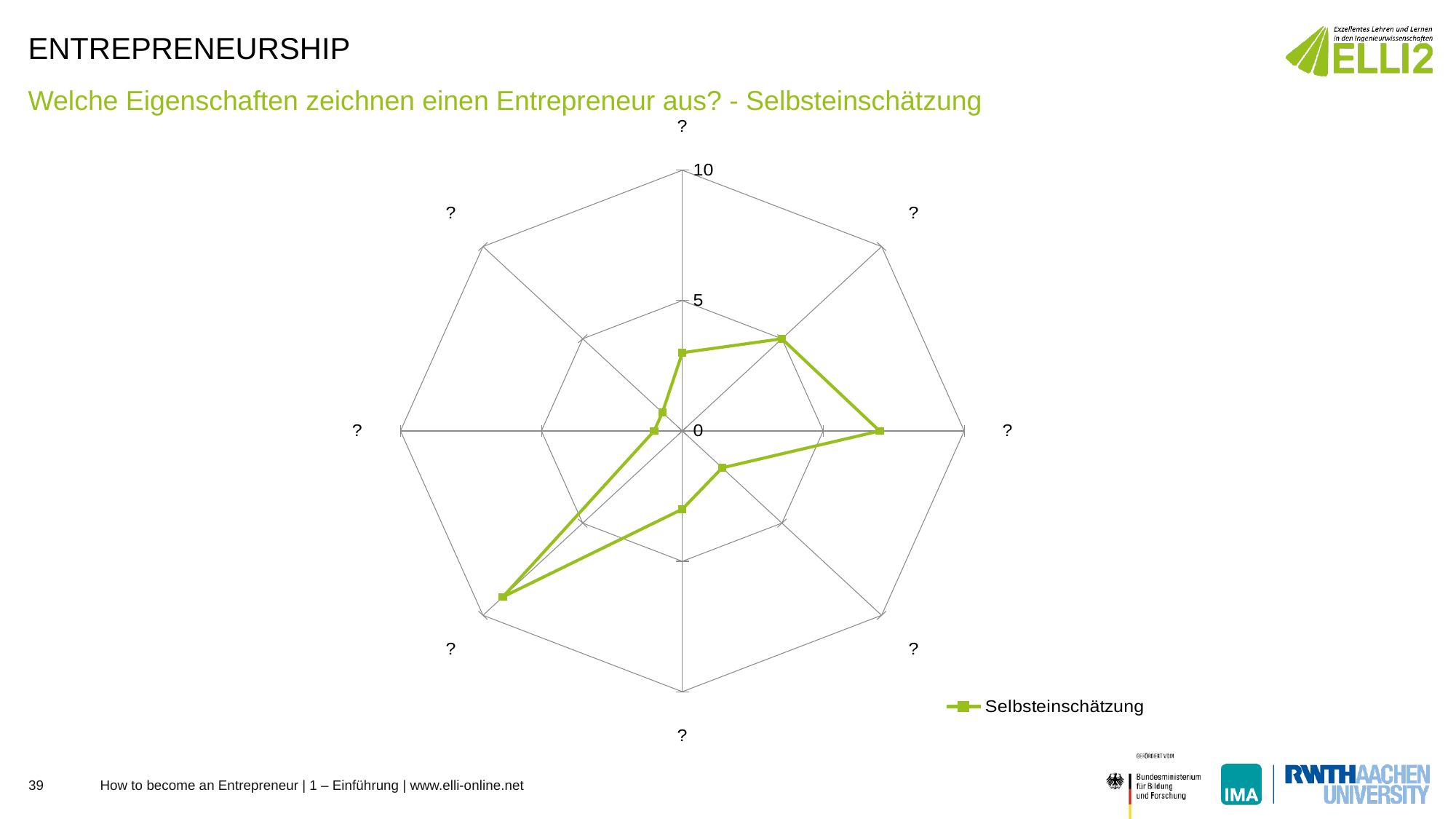
Is the value on the axis pointing straight up greater or less than 5? less Is the value on the axis pointing to the left greater or less than 5? less What kind of chart is shown on the slide? radar chart What is the name of the series shown in the chart legend? Selbsteinschätzung What is the maximum value shown on the radar chart's scale? 10 Is the value on the axis pointing to the lower left greater or less than 5? greater How many axes (categories) does the radar chart have? 8 Which is larger: the value on the axis pointing to the lower left or the value on the axis pointing to the left? the lower-left axis How many series does the chart legend list? 1